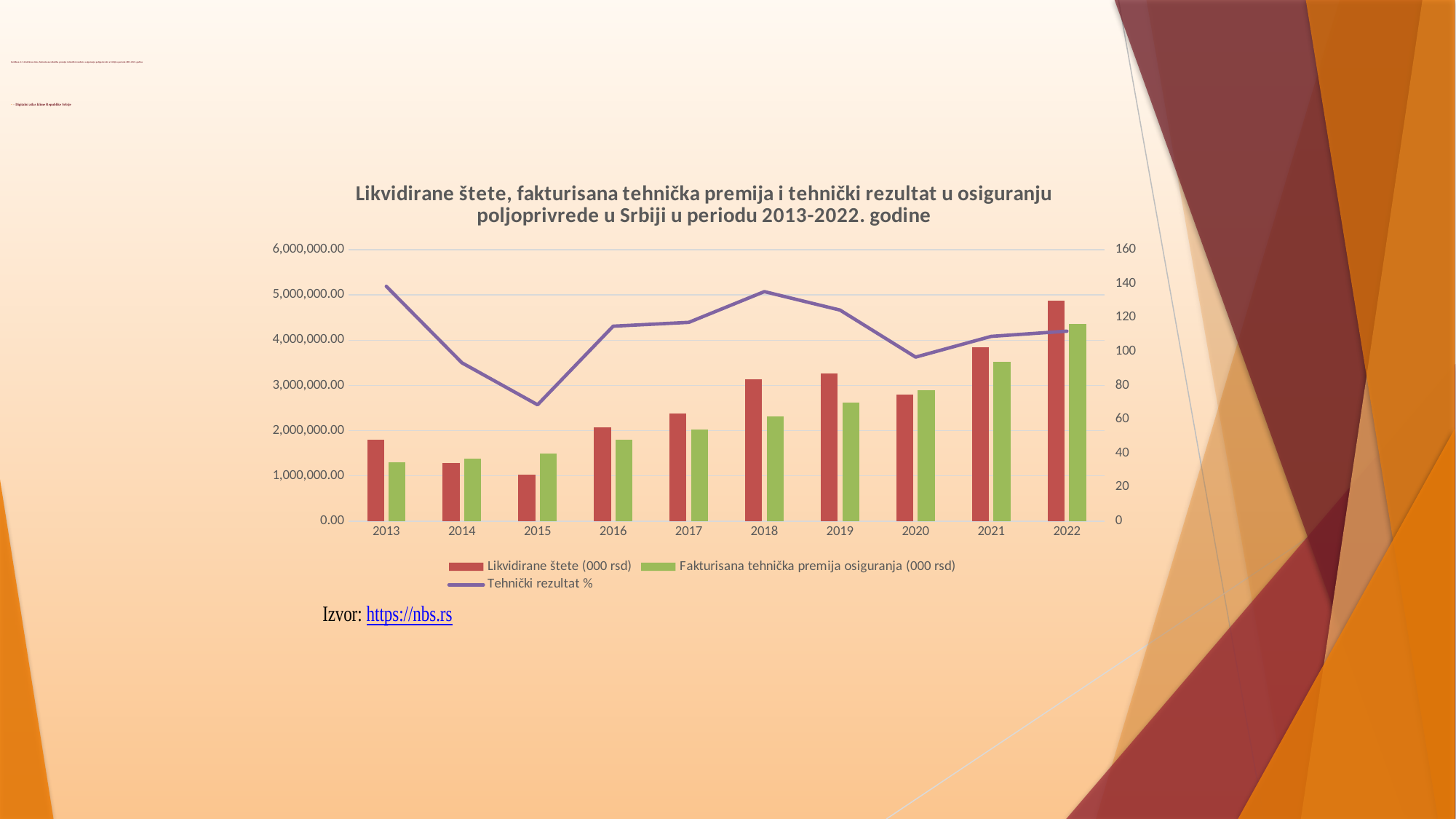
In 2013, which is larger: Likvidirane štete or Fakturisana tehnička premija osiguranja? Likvidirane štete In which year is Fakturisana tehnička premija osiguranja (000 rsd) lowest? 2013 Is the value of Likvidirane štete (000 rsd) in 2022 greater or less than 4,000,000.00? greater How many series does the legend list? 3 In 2015, which is larger: Likvidirane štete or Fakturisana tehnička premija osiguranja? Fakturisana tehnička premija osiguranja In which year is Tehnički rezultat % lowest? 2015 In which year is Fakturisana tehnička premija osiguranja (000 rsd) highest? 2022 How many years are shown on the x axis? 10 In which year is Likvidirane štete (000 rsd) highest? 2022 What kind of chart is shown on the slide? A bar chart combined with a line Is the Tehnički rezultat % in 2015 greater or less than 80? less In which year is Likvidirane štete (000 rsd) lowest? 2015